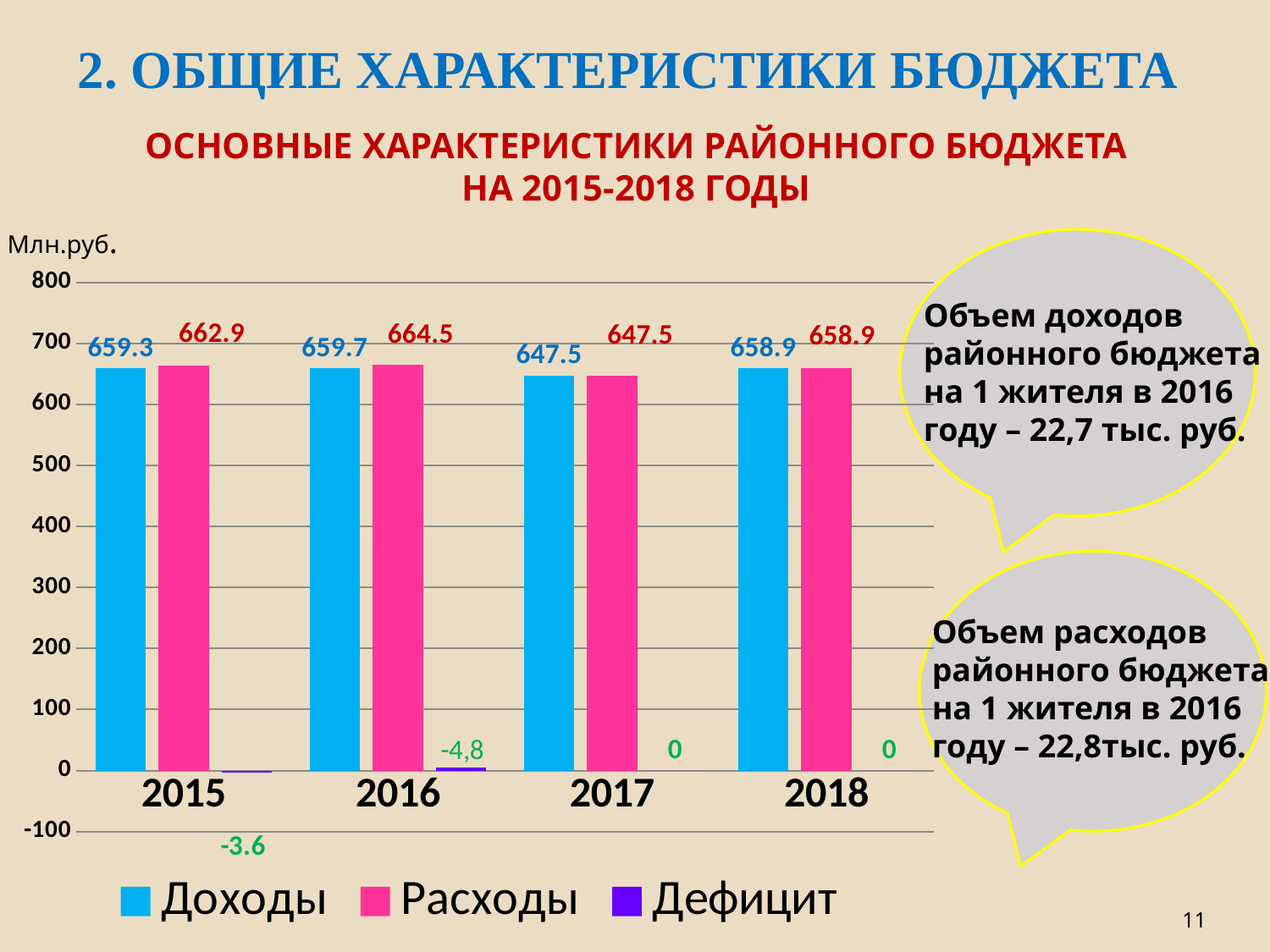
What unit is shown above the y axis of the chart? Млн.руб. What kind of chart is shown on the slide? Bar chart How many series does the legend list? 3 How many years are shown on the x axis? 4 What is the value of Расходы for 2015? 662.9 In which year is Расходы highest? 2016 What is the difference between Расходы and Доходы in 2016? 4.8 What is the value of Доходы for 2016? 659.7 Which is larger in 2015, Доходы or Расходы? Расходы What is the value of Дефицит for 2016? -4,8 In which year is Доходы lowest? 2017 What is the value of Дефицит for 2015? -3.6